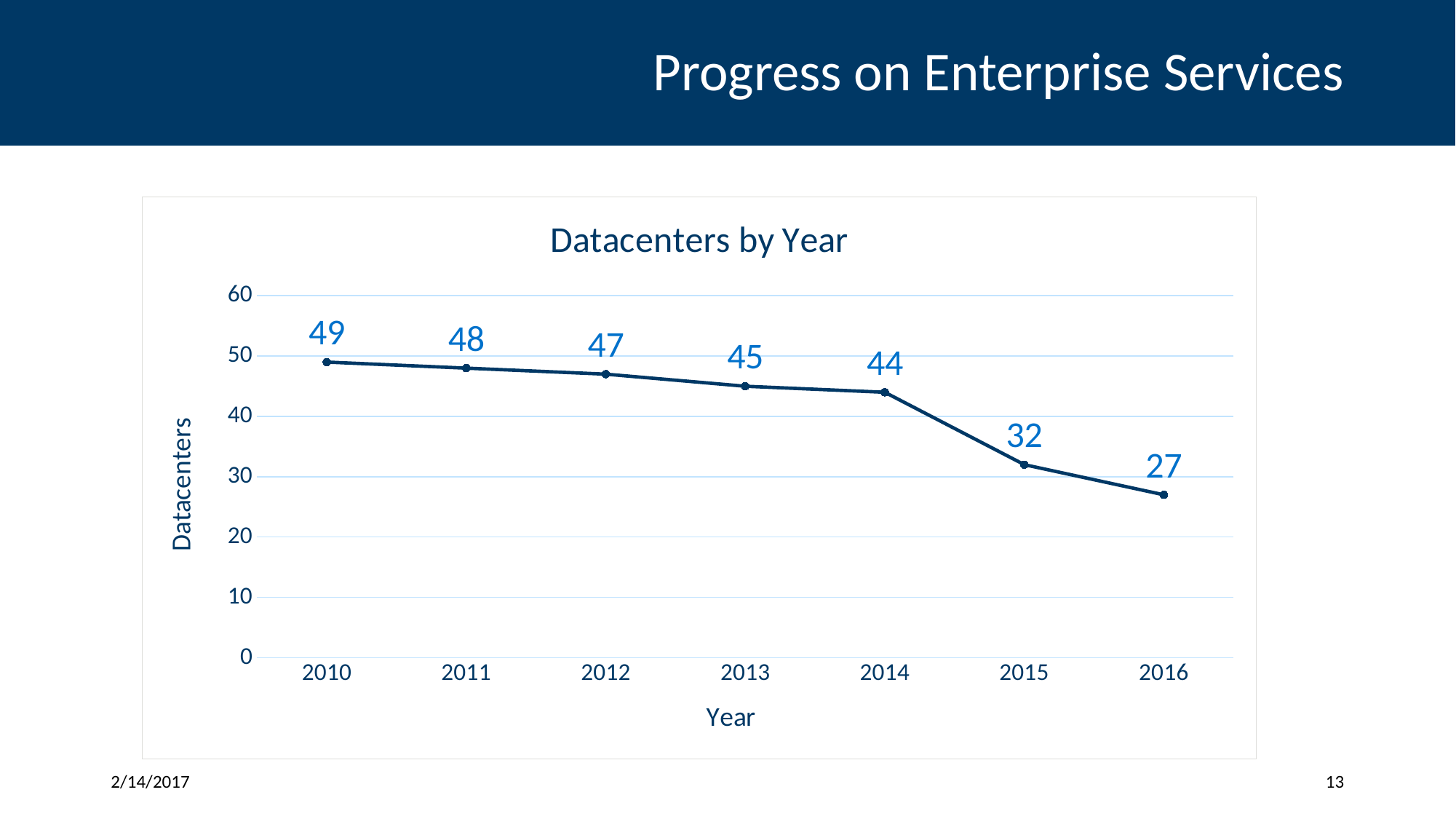
Do the values rise or fall from 2010 to 2016? fall What is the number of datacenters in 2014? 44 What is the difference in datacenters between 2010 and 2016? 22 Which year has the lowest number of datacenters? 2016 How many years are plotted on the chart? 7 What is the difference in datacenters between 2014 and 2015? 12 Which year has the highest number of datacenters? 2010 What kind of chart is shown on the slide? line chart Is the value for 2015 greater or less than 40? less What is the number of datacenters in 2010? 49 Which year has more datacenters, 2013 or 2015? 2013 What is the number of datacenters in 2016? 27